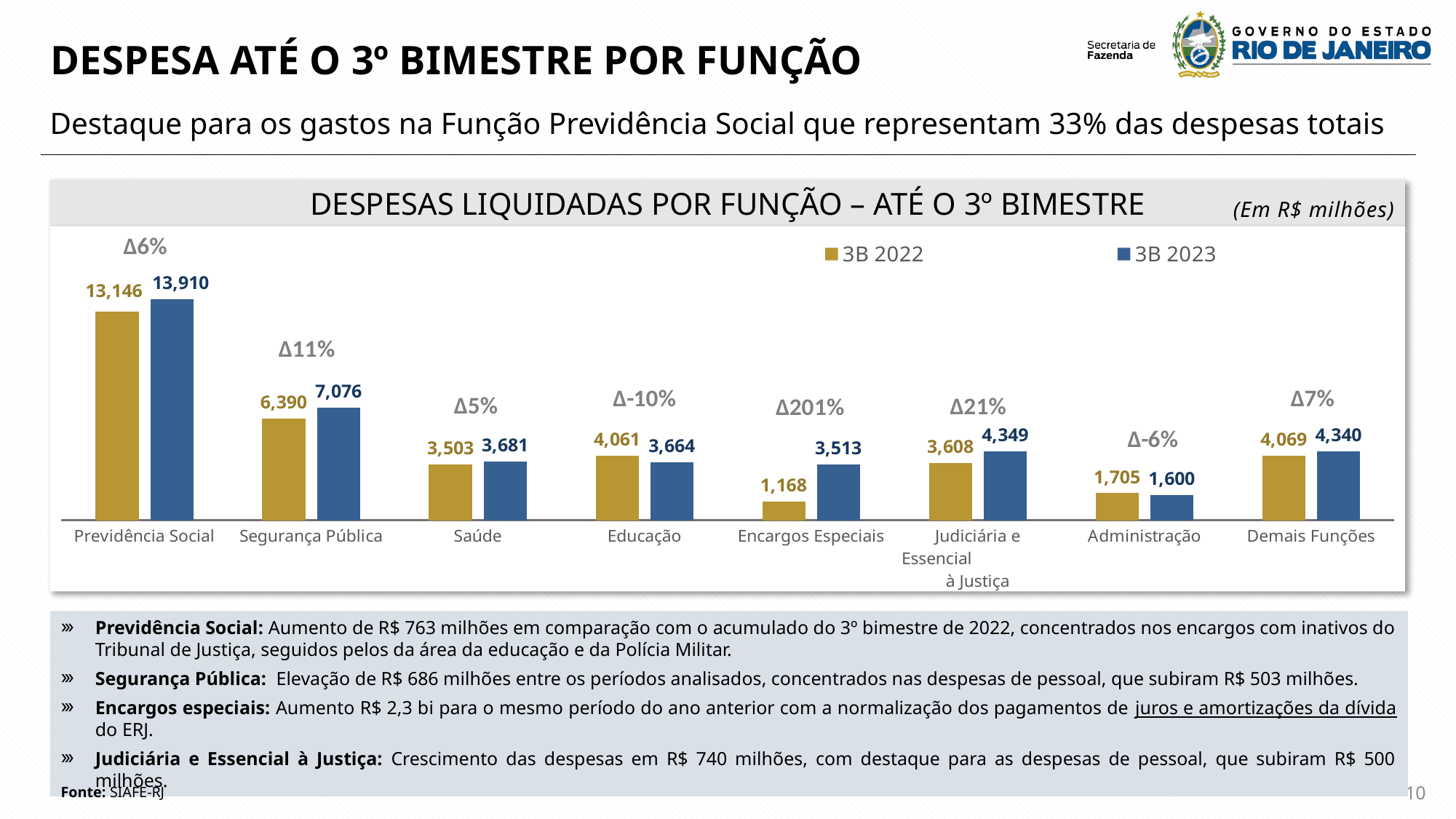
Which category has the highest value in the 3B 2023 series? Previdência Social What is the value for Previdência Social in the 3B 2023 series? 13,910 For Educação, which is larger: the 3B 2022 value or the 3B 2023 value? 3B 2022 How many categories are shown on the x axis of the chart? 8 Which category has the lowest value in the 3B 2023 series? Administração How many series does the legend list? 2 What kind of chart is shown on the slide? Bar chart What is the value for Administração in the 3B 2023 series? 1,600 What is the value for Encargos Especiais in the 3B 2022 series? 1,168 What is the difference between the 3B 2023 and 3B 2022 values for Encargos Especiais? 2,345 Which category has the lowest value in the 3B 2022 series? Encargos Especiais What is the difference between the 3B 2023 and 3B 2022 values for Segurança Pública? 686